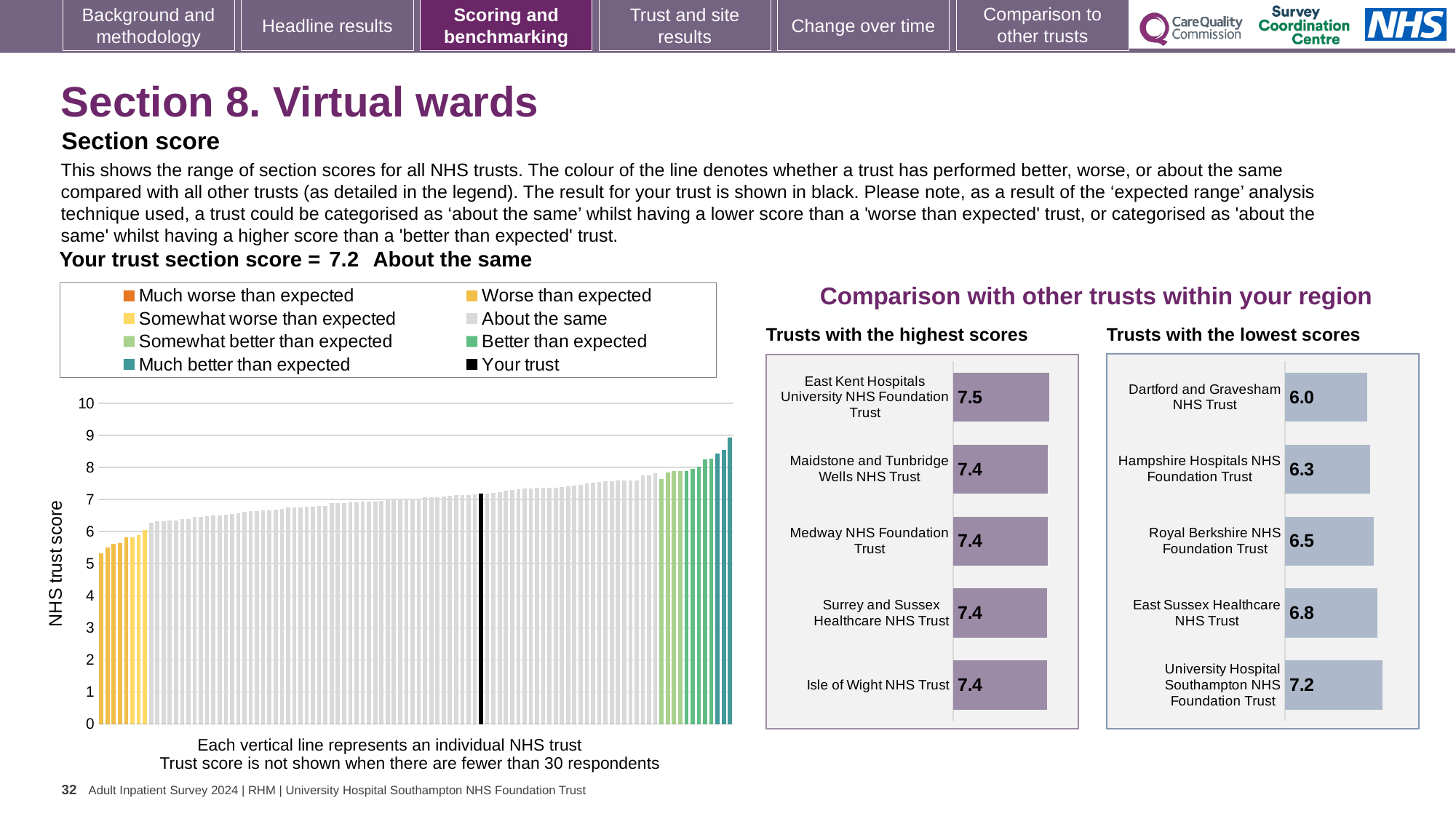
In the main 'NHS trust score' chart on the left, is the value of the tallest bar greater or less than 8? greater In the 'Trusts with the lowest scores' chart, what is the difference between the scores of University Hospital Southampton NHS Foundation Trust and Dartford and Gravesham NHS Trust? 1.2 In the 'Trusts with the lowest scores' chart, which has the larger score: East Sussex Healthcare NHS Trust or Hampshire Hospitals NHS Foundation Trust? East Sussex Healthcare NHS Trust In the 'Trusts with the highest scores' chart, how many trusts are shown? 5 In the main 'NHS trust score' chart on the left, how many entries does the legend list? 8 In the main 'NHS trust score' chart on the left, do the values rise or fall from left to right? Rise In the 'Trusts with the lowest scores' chart, what is the score for Royal Berkshire NHS Foundation Trust? 6.5 In the 'Trusts with the lowest scores' chart, what is the score for Dartford and Gravesham NHS Trust? 6.0 In the 'Trusts with the highest scores' chart, which trust has the highest score? East Kent Hospitals University NHS Foundation Trust What kind of chart is the main 'NHS trust score' chart on the left? Bar chart In the 'Trusts with the lowest scores' chart, which trust has the lowest score? Dartford and Gravesham NHS Trust In the 'Trusts with the highest scores' chart, what is the score for East Kent Hospitals University NHS Foundation Trust? 7.5